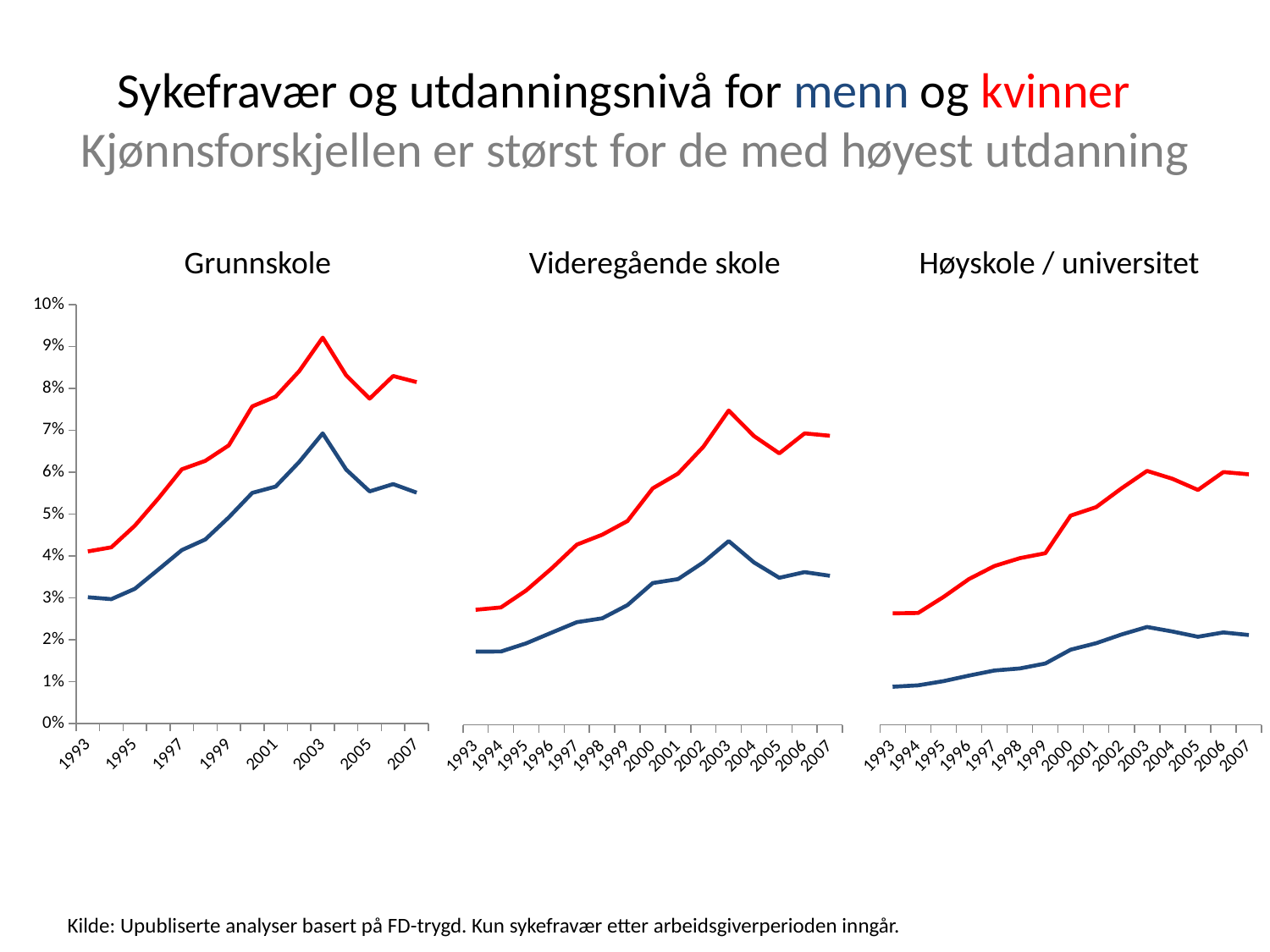
In the Grunnskole chart, is the value for kvinner (red line) in 2003 greater or less than 9%? greater What is the title of the rightmost chart on the slide? Høyskole / universitet In the Høyskole / universitet chart, which line is higher in 2007, kvinner (red) or menn (blue)? kvinner (red) How many years are plotted along the x axis of the Videregående skole chart? 15 In the Høyskole / universitet chart, does the menn (blue) line rise or fall from 1993 to 2003? rise What kind of chart is the Grunnskole chart? line chart In the Høyskole / universitet chart, is the value for menn (blue line) in 2003 greater or less than 3%? less In the Videregående skole chart, is the value for kvinner (red line) in 1993 greater or less than 2%? greater In the Videregående skole chart, in which year does the kvinner (red) line reach its highest value? 2003 Which colour represents kvinner in the charts? red In the Grunnskole chart, in which year does the kvinner (red) line reach its highest value? 2003